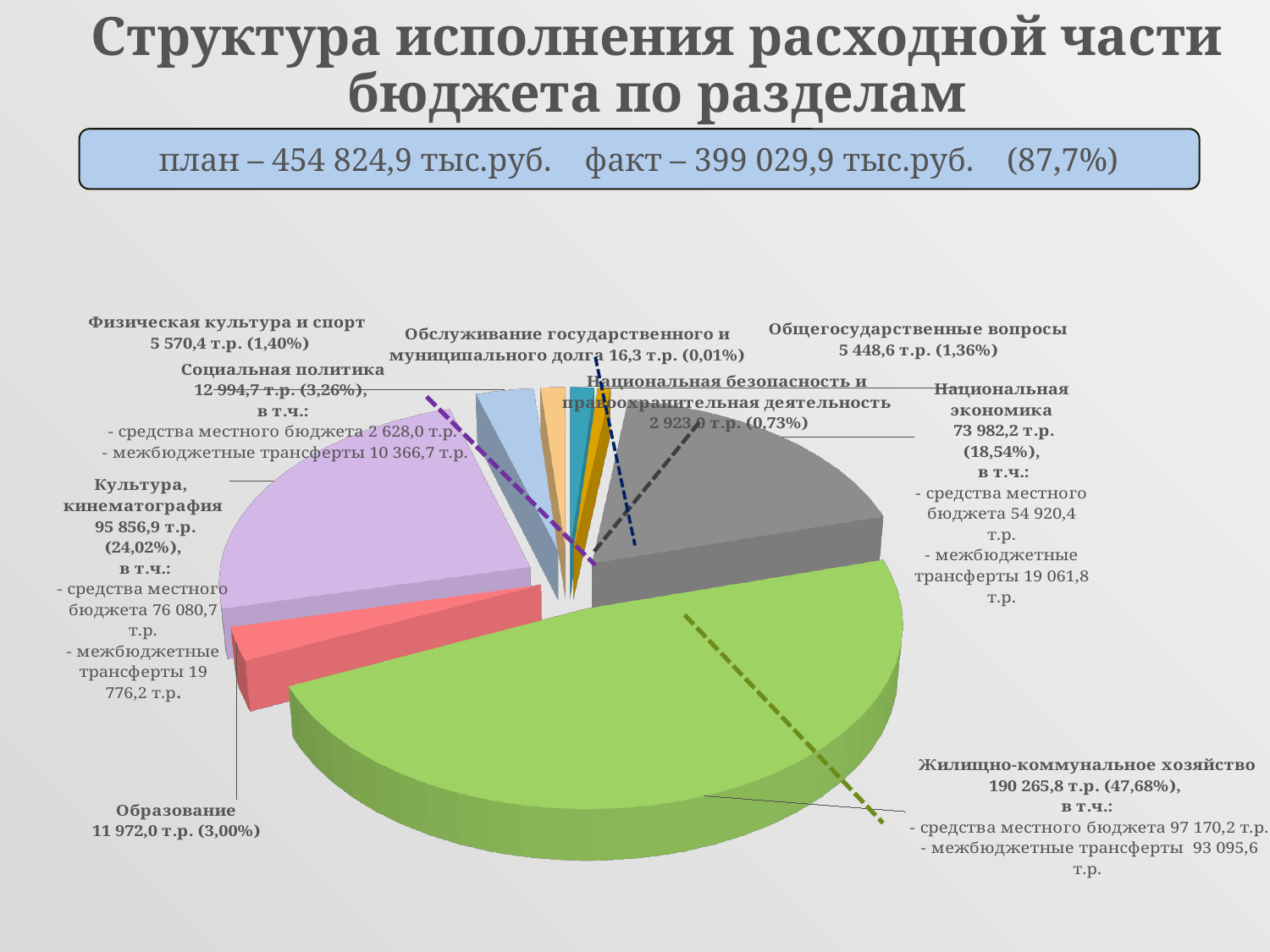
What percentage is shown for Культура, кинематография? 24,02% Which section has the largest share of the pie? Жилищно-коммунальное хозяйство What is the value shown for Обслуживание государственного и муниципального долга? 16,3 т.р. What kind of chart is shown on the slide? pie chart How many sections (slices) does the pie chart show? 9 What is the fact (факт) value of budget expenditure stated in the box under the title? 399 029,9 тыс.руб. What is the value shown for Образование? 11 972,0 т.р. What is the value shown for Национальная экономика? 73 982,2 т.р. Which section has the smallest share of the pie? Обслуживание государственного и муниципального долга What is the difference in percentage points between Жилищно-коммунальное хозяйство (47,68%) and Культура, кинематография (24,02%)? 23,66 Which is larger: Физическая культура и спорт or Общегосударственные вопросы? Физическая культура и спорт What share of the pie does Жилищно-коммунальное хозяйство account for? 47,68%